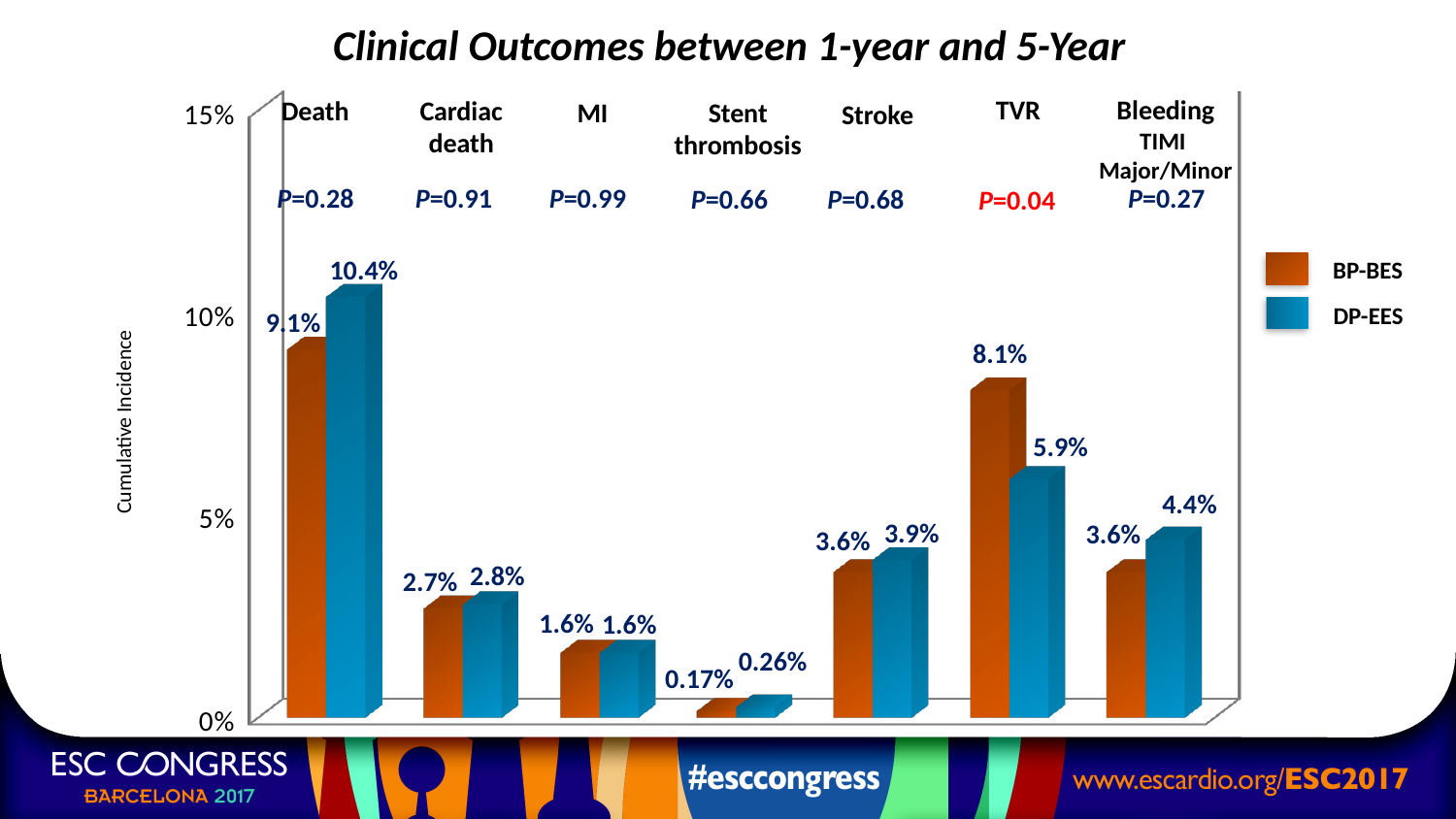
What is the difference between the DP-EES and BP-BES values for Death? 1.3% What type of chart is shown on the slide? bar chart What is the difference between the BP-BES and DP-EES values for TVR? 2.2% What is the cumulative incidence of Death for BP-BES? 9.1% For TVR, which group has the larger value, BP-BES or DP-EES? BP-BES Which outcome category has the lowest value for BP-BES? Stent thrombosis What is the value for Stent thrombosis in the DP-EES group? 0.26% How many series does the legend list? 2 Is the BP-BES value for Death greater or less than 5%? greater How many outcome categories are shown on the x axis? 7 What is the cumulative incidence of TVR for DP-EES? 5.9% Which outcome category has the highest value for DP-EES? Death